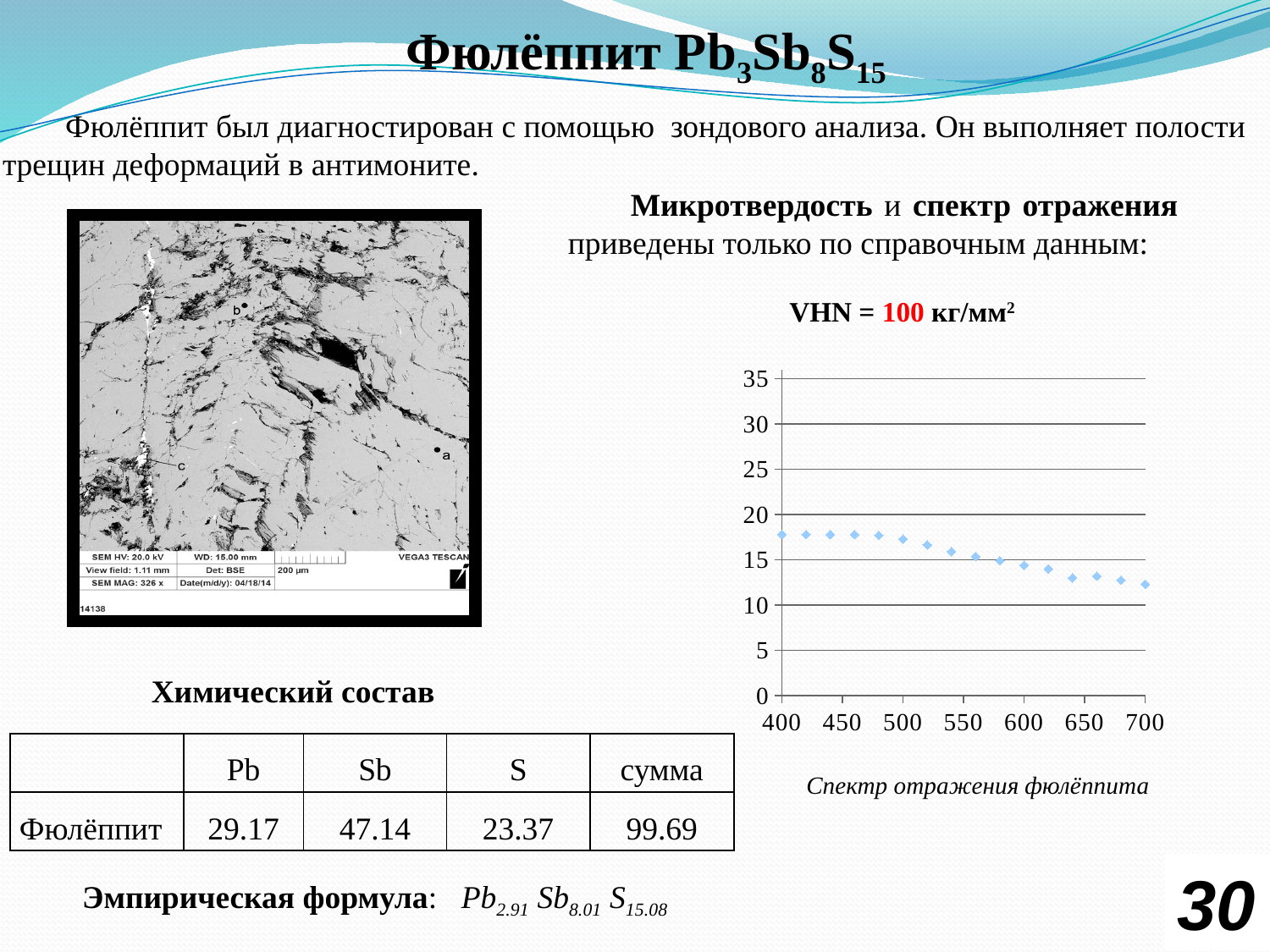
Which is larger in the reflection spectrum chart: the value at x = 400 or the value at x = 700? the value at x = 400 What kind of chart is shown on the slide? scatter chart What is the highest value shown on the y axis of the reflection spectrum chart? 35 Is the value at x = 700 in the reflection spectrum chart greater or less than 15? less Is the value at x = 400 in the reflection spectrum chart greater or less than 15? greater Which is larger in the reflection spectrum chart: the value at x = 500 or the value at x = 650? the value at x = 500 Do the values in the reflection spectrum chart rise or fall as the x axis goes from 400 to 700? fall Is the value at x = 700 in the reflection spectrum chart greater or less than 10? greater What range does the x axis of the reflection spectrum chart cover? 400 to 700